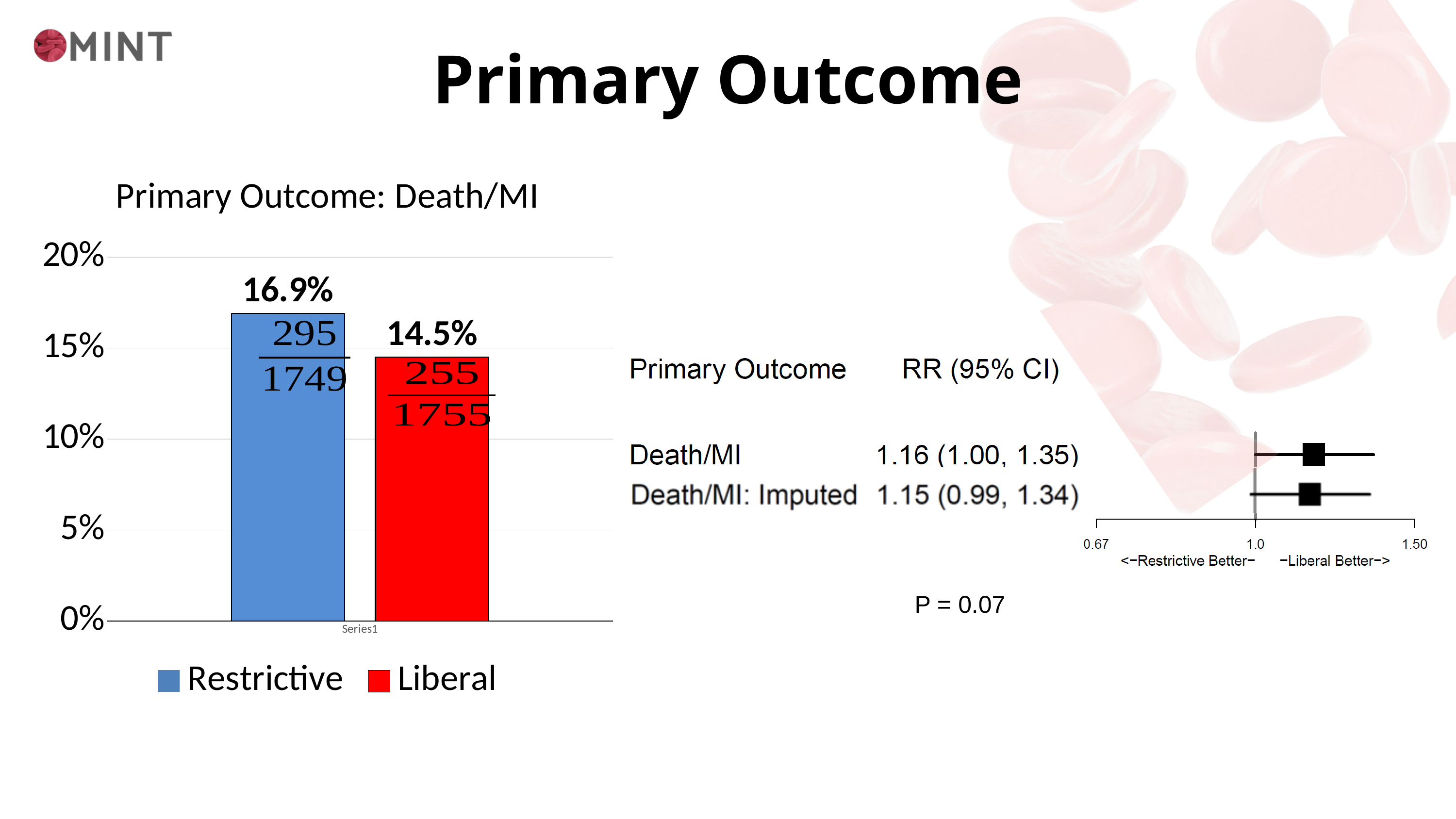
How many series does the legend of the bar chart titled 'Primary Outcome: Death/MI' list? 2 In the bar chart titled 'Primary Outcome: Death/MI', is the value for Restrictive greater or less than 15%? greater In the bar chart titled 'Primary Outcome: Death/MI', is the value for Liberal greater or less than 15%? less In the bar chart titled 'Primary Outcome: Death/MI', which series has the higher value? Restrictive In the forest plot on the right, what is the RR (95% CI) for Death/MI? 1.16 (1.00, 1.35) In the bar chart titled 'Primary Outcome: Death/MI', what fraction is printed on the Restrictive bar? 295/1749 In the bar chart titled 'Primary Outcome: Death/MI', what is the value for Liberal? 14.5% In the bar chart titled 'Primary Outcome: Death/MI', which series has the lower value? Liberal In the bar chart titled 'Primary Outcome: Death/MI', what is the difference between the Restrictive and Liberal values? 2.4% What kind of chart is the chart titled 'Primary Outcome: Death/MI'? bar chart In the bar chart titled 'Primary Outcome: Death/MI', what is the value for Restrictive? 16.9% In the bar chart titled 'Primary Outcome: Death/MI', what colour is the Liberal bar? red